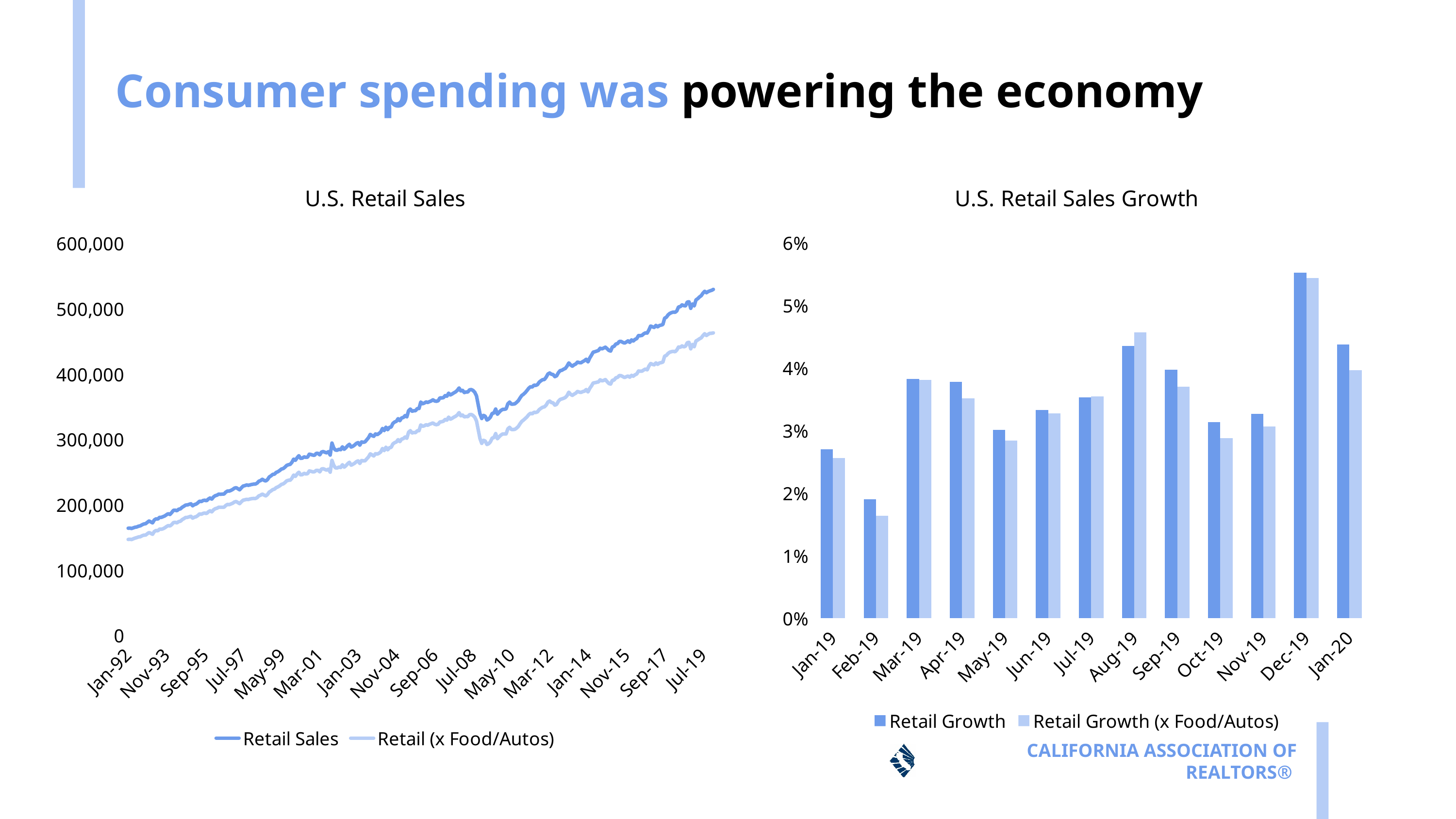
In the U.S. Retail Sales Growth chart, is the Retail Growth value for Dec-19 greater or less than 5%? greater In the U.S. Retail Sales Growth chart, which month has the lowest Retail Growth? Feb-19 In the U.S. Retail Sales chart, is the Retail Sales value at Jul-19 greater or less than 500,000? greater What type of chart is the U.S. Retail Sales chart on the left? line chart In the U.S. Retail Sales Growth chart, is Retail Growth higher in Aug-19 or Sep-19? Aug-19 How many series does the legend of the U.S. Retail Sales chart list? 2 In the U.S. Retail Sales chart, do Retail Sales generally rise or fall from Jan-92 to Jul-19? rise In the U.S. Retail Sales Growth chart, is the Retail Growth value for Feb-19 greater or less than 2%? less What type of chart is the U.S. Retail Sales Growth chart on the right? bar chart In the U.S. Retail Sales Growth chart, which month has the highest Retail Growth? Dec-19 What is the second series listed in the legend of the U.S. Retail Sales Growth chart? Retail Growth (x Food/Autos) How many months are shown on the x axis of the U.S. Retail Sales Growth chart? 13